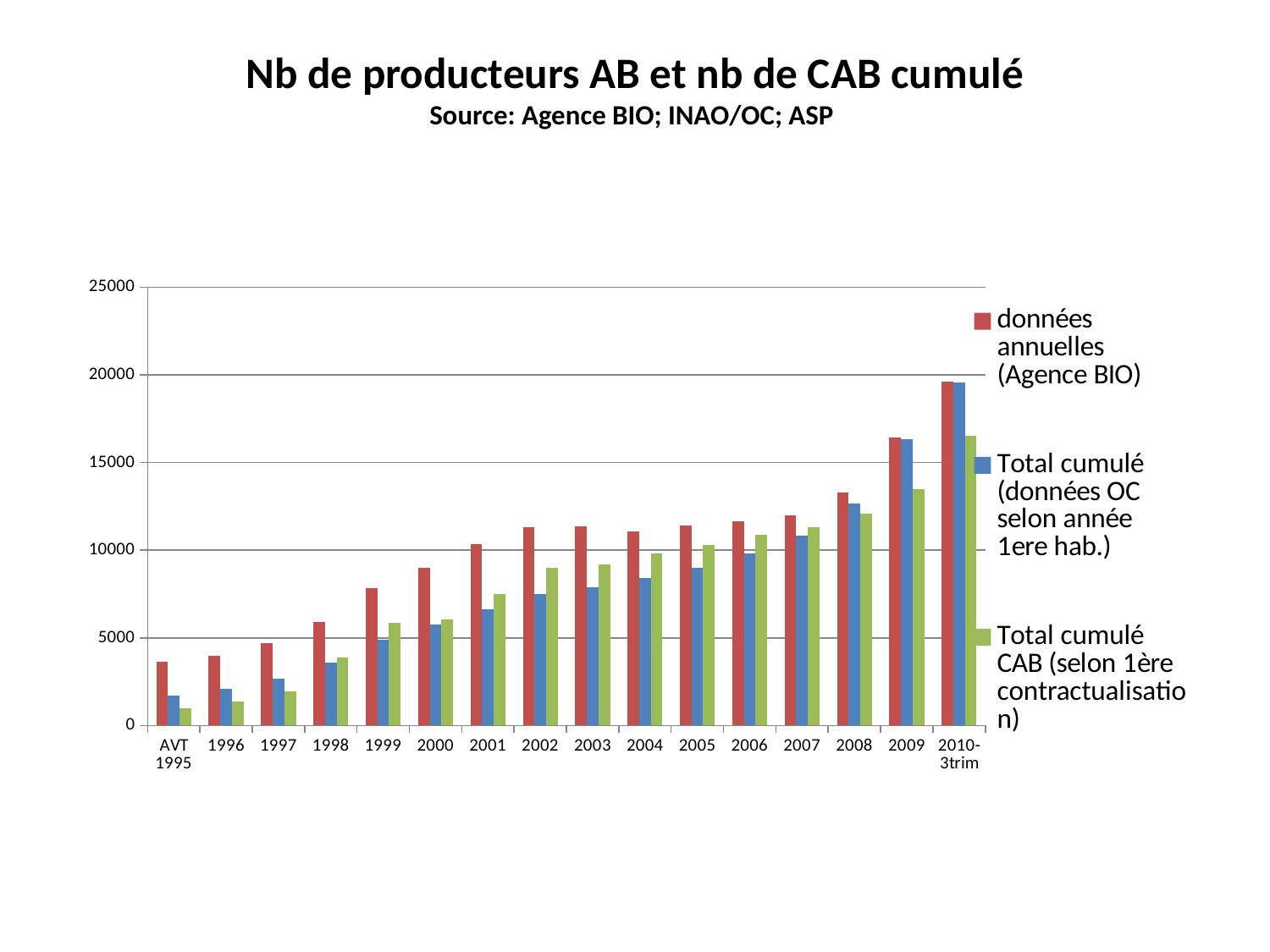
What kind of chart is shown on the slide? bar chart Which category has the highest value for the 'données annuelles (Agence BIO)' series? 2010-3trim Is the 'données annuelles (Agence BIO)' value for 1999 greater or less than 10000? less Is the 'Total cumulé (données OC selon année 1ere hab.)' value for 2005 greater or less than 10000? less Which category has the lowest value for the 'Total cumulé CAB (selon 1ère contractualisation)' series? AVT 1995 Do the 'Total cumulé CAB (selon 1ère contractualisation)' values generally rise or fall from AVT 1995 to 2010-3trim? rise Is the 'Total cumulé CAB (selon 1ère contractualisation)' value for 2009 greater or less than 10000? greater How many categories are shown on the x axis? 16 For 2001, which is larger: 'données annuelles (Agence BIO)' or 'Total cumulé (données OC selon année 1ere hab.)'? données annuelles (Agence BIO) What is the title of the chart? Nb de producteurs AB et nb de CAB cumulé How many series does the legend list? 3